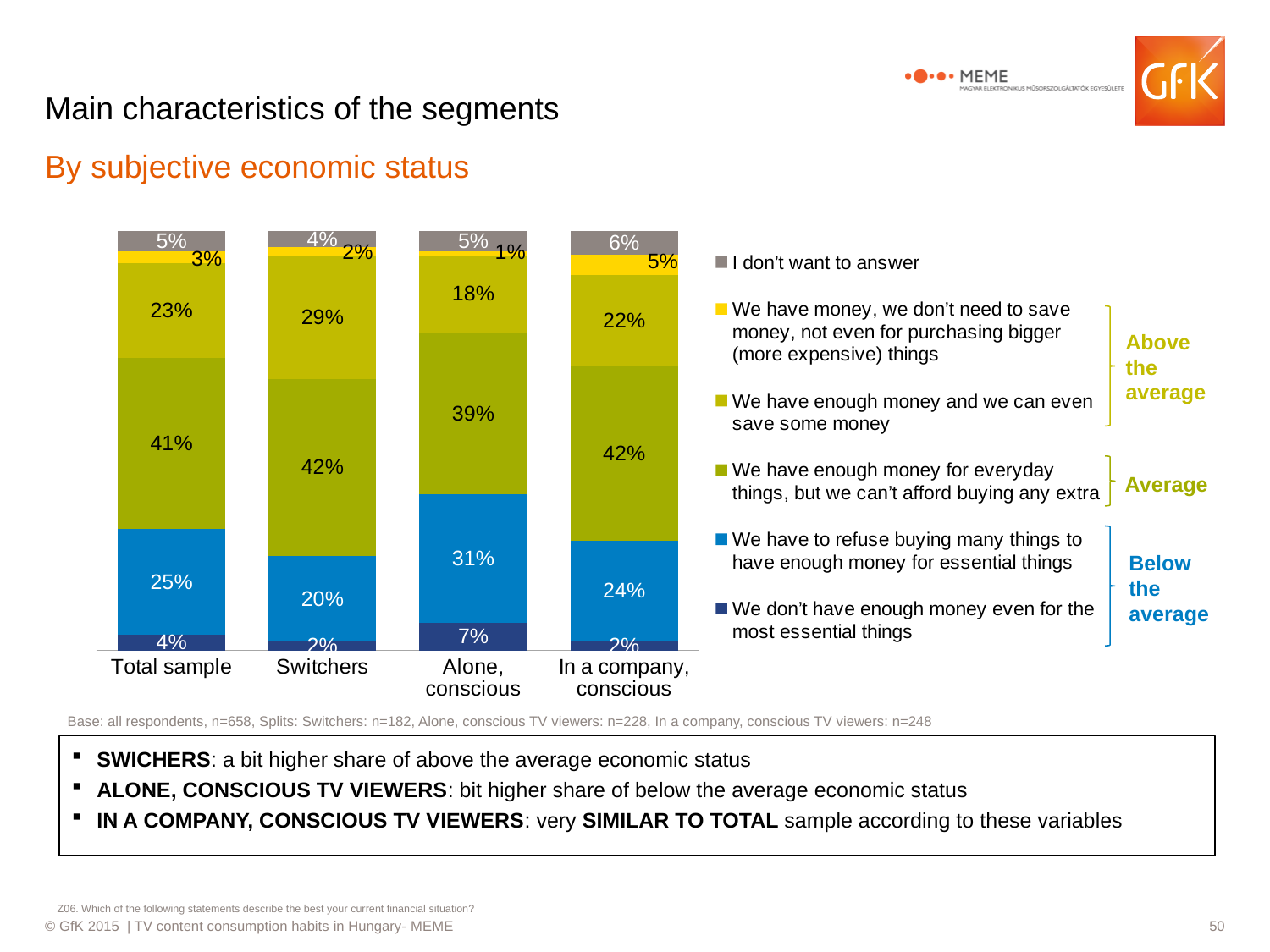
Which is larger: the 'We have money, we don't need to save money' share for In a company, conscious or for Switchers? In a company, conscious Which legend entries are grouped under the label 'Below the average'? We have to refuse buying many things to have enough money for essential things; We don't have enough money even for the most essential things What percentage of the In a company, conscious segment says 'I don't want to answer'? 6% What is the difference between the Switchers and Total sample shares for 'We have to refuse buying many things to have enough money for essential things'? 5% What percentage of the Alone, conscious segment says 'We have to refuse buying many things to have enough money for essential things'? 31% Which segment has the highest share for 'We don't have enough money even for the most essential things'? Alone, conscious What percentage of Switchers says 'We have enough money and we can even save some money'? 29% What type of chart is shown on the slide? Stacked bar chart Which segment has the lowest share for 'We have enough money and we can even save some money'? Alone, conscious How many series does the chart's legend list? 6 How many segments (categories) are shown along the x axis of the chart? 4 What percentage of the Total sample says 'We have enough money for everyday things, but we can't afford buying any extra'? 41%